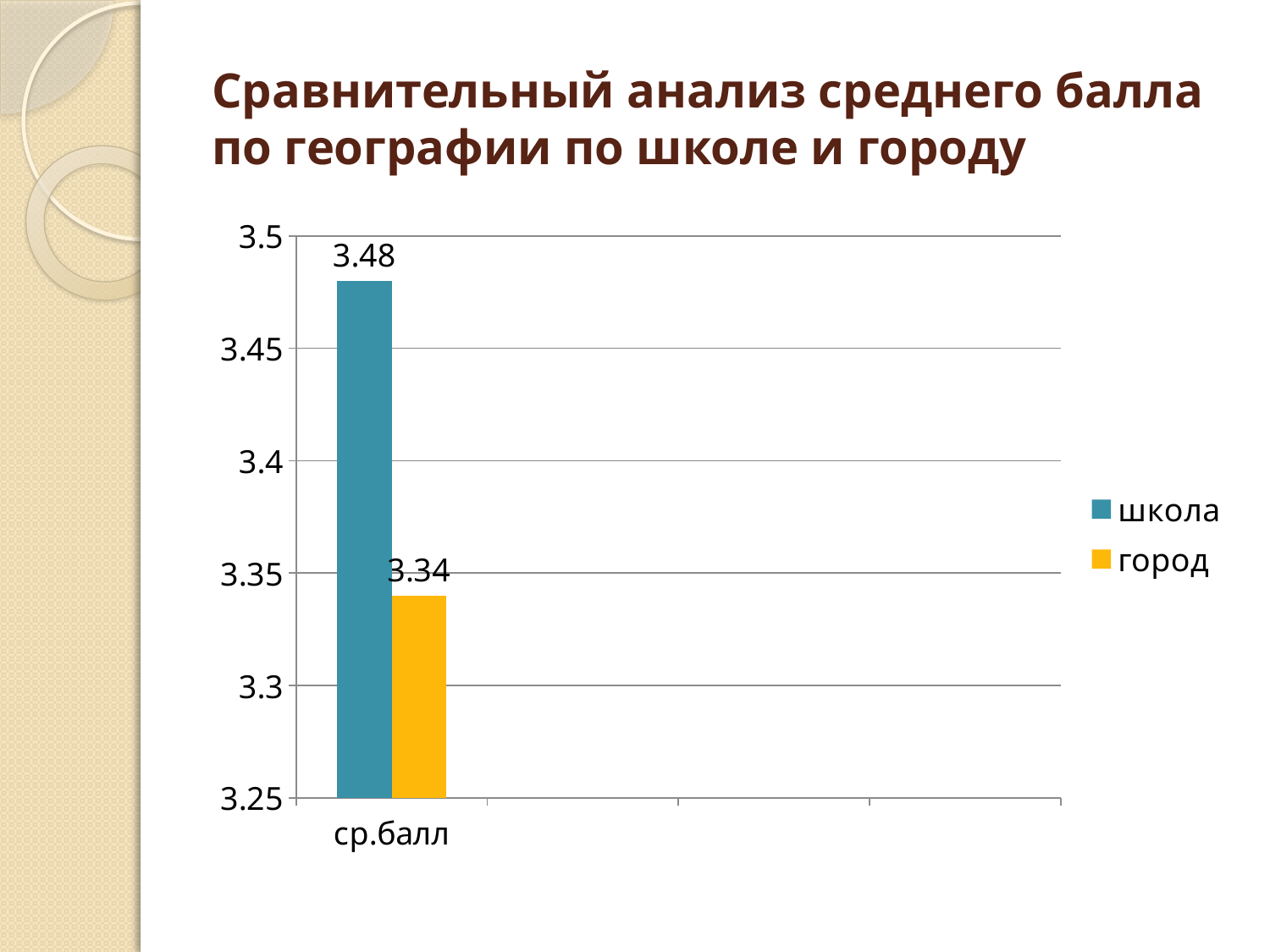
Which series has the higher value, школа or город? школа Which series has the lowest value in the chart? город What is the value for школа (school) in the chart? 3.48 What is the category label on the x axis? ср.балл What is the value for город (city) in the chart? 3.34 What kind of chart is shown on the slide? bar chart What colour is the bar for город? yellow Is the value for город greater or less than 3.35? less How many series does the legend list? 2 What is the difference between the школа value and the город value? 0.14 Is the value for школа greater or less than 3.45? greater What is the highest value shown on the y axis? 3.5